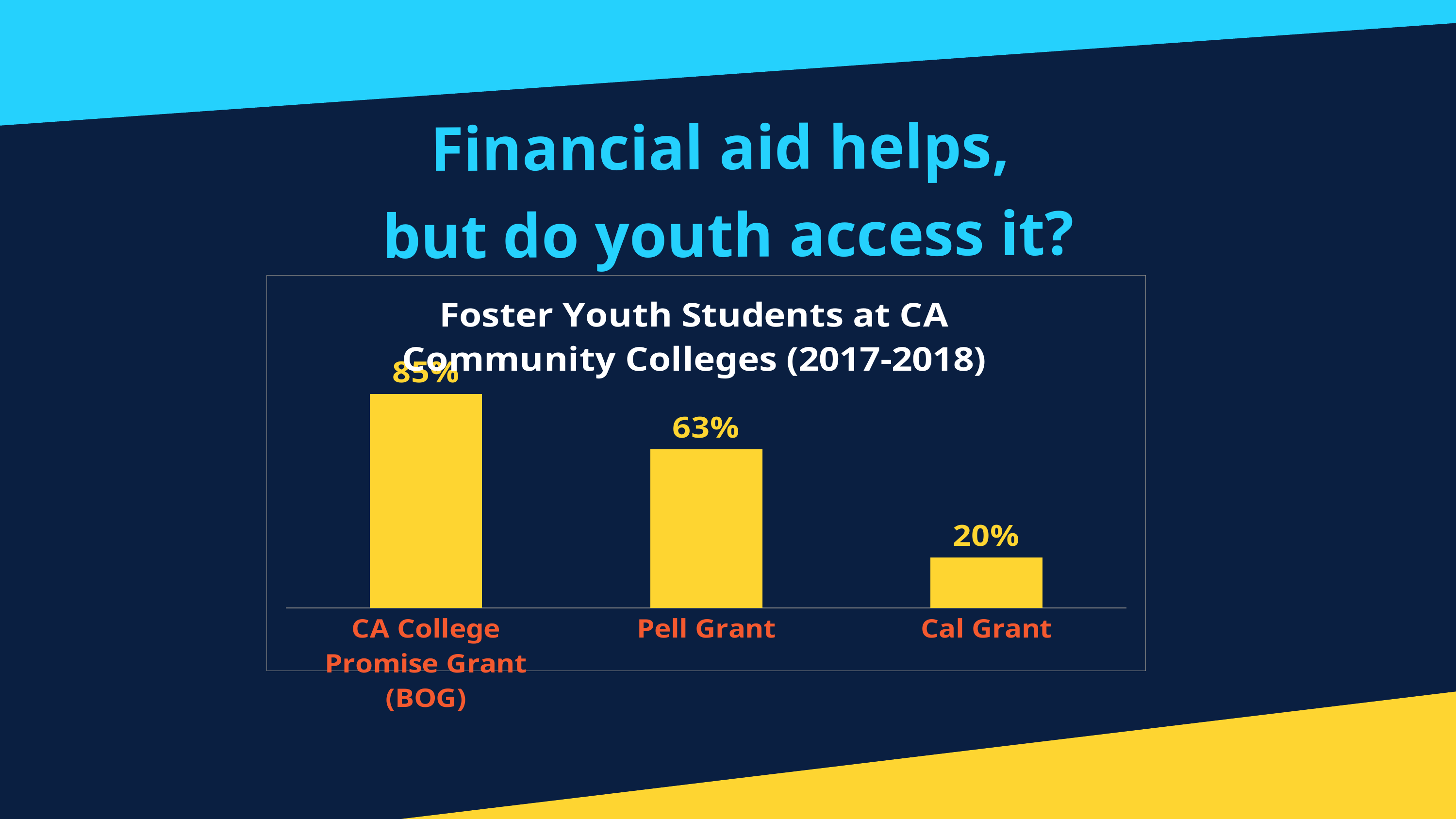
Which is larger, the value for Pell Grant or the value for Cal Grant? Pell Grant What kind of chart is shown on the slide? Bar chart Do the values rise or fall from left to right across the categories? Fall What is the title of the chart? Foster Youth Students at CA Community Colleges (2017-2018) What is the value for Pell Grant? 63% What is the difference between the values for Pell Grant and Cal Grant? 43% How many categories are shown in the chart? 3 What is the difference between the values for CA College Promise Grant (BOG) and Pell Grant? 22% What is the value for Cal Grant? 20% Which category has the highest value? CA College Promise Grant (BOG) Which category has the lowest value? Cal Grant What is the value for CA College Promise Grant (BOG)? 85%